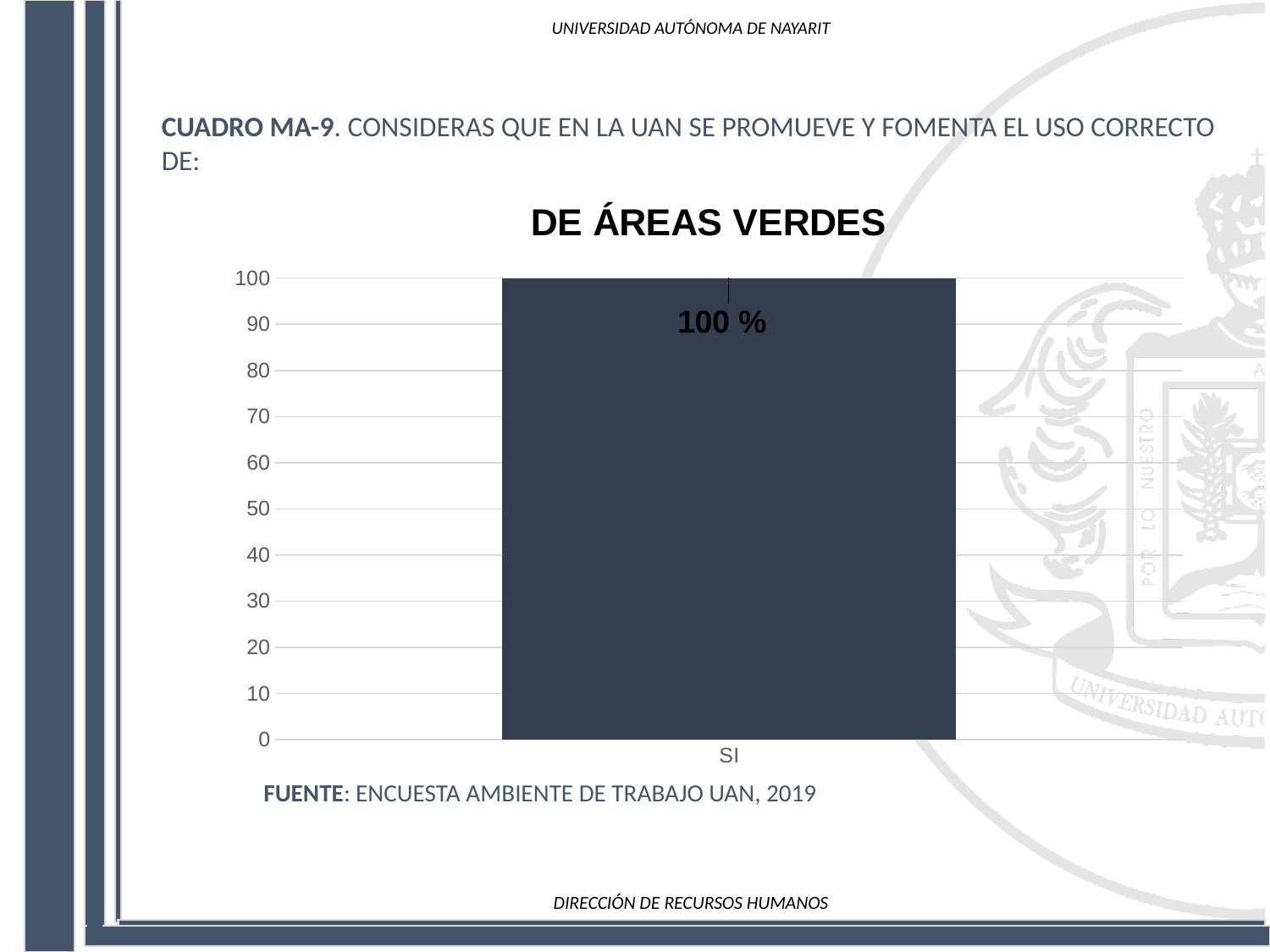
What is the highest value shown on the vertical axis? 100 How many categories are plotted in the chart? 1 Is the value for SI greater or less than 50? greater What is the value for SI in the chart? 100 % What is the label of the only category on the x axis? SI What is the title of the chart? DE ÁREAS VERDES What kind of chart is shown on the slide? bar chart